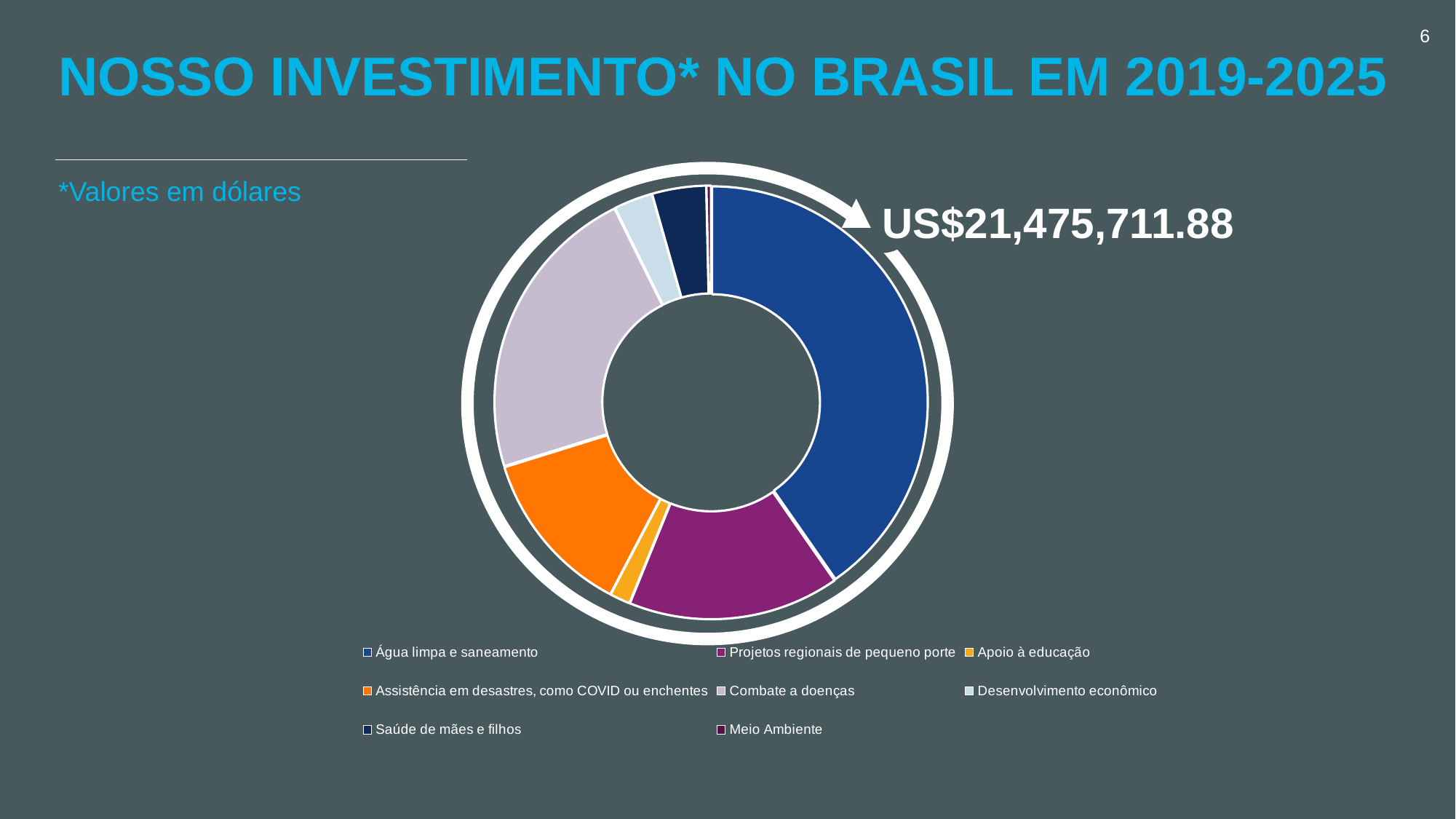
Which category has the largest slice of the chart? Água limpa e saneamento Which slice is larger: Água limpa e saneamento or Combate a doenças? Água limpa e saneamento What is the title of the slide containing the chart? NOSSO INVESTIMENTO* NO BRASIL EM 2019-2025 What kind of chart is shown on the slide? Doughnut (pie) chart Which slice is larger: Combate a doenças or Saúde de mães e filhos? Combate a doenças Which category has the smallest slice of the chart? Meio Ambiente How many categories does the chart's legend list? 8 What total investment value is annotated next to the chart? US$21,475,711.88 Which slice is larger: Assistência em desastres, como COVID ou enchentes or Apoio à educação? Assistência em desastres, como COVID ou enchentes